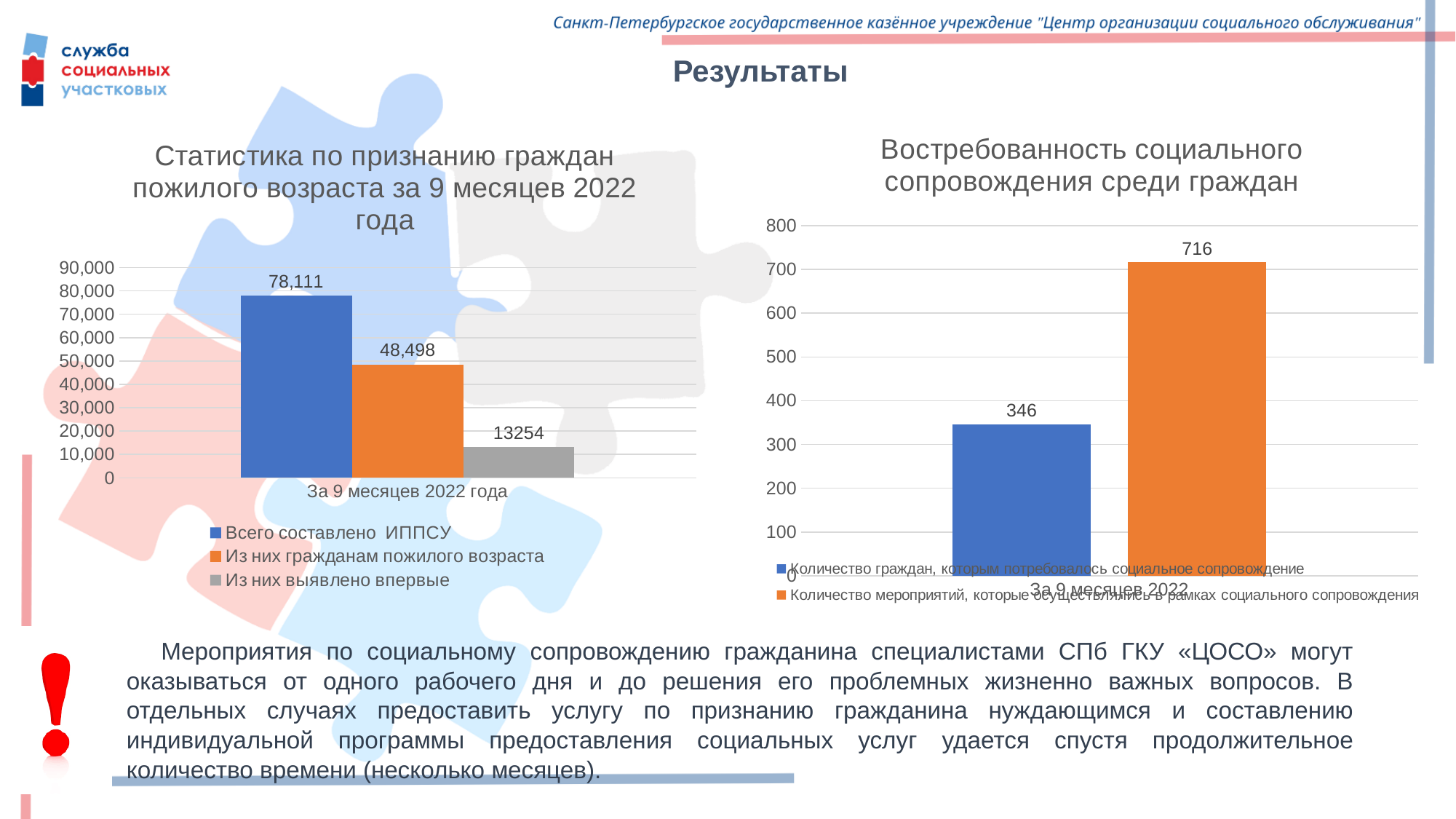
What kind of chart is the right chart? bar chart On the right chart, what colour is the bar for Количество мероприятий, которые осуществлялись в рамках социального сопровождения? orange On the left chart, what is the value for Из них выявлено впервые? 13254 On the left chart, which series has the lowest value? Из них выявлено впервые On the right chart, what is the difference between the number of мероприятий (716) and the number of граждан (346)? 370 On the left chart, what is the value for Из них гражданам пожилого возраста? 48,498 On the right chart (Востребованность социального сопровождения среди граждан), what is the value for Количество граждан, которым потребовалось социальное сопровождение? 346 On the left chart, how many series does the legend list? 3 On the right chart, what is the value for Количество мероприятий, которые осуществлялись в рамках социального сопровождения? 716 On the left chart, what is the difference between Всего составлено ИППСУ and Из них гражданам пожилого возраста? 29,613 On the left chart (Статистика по признанию граждан пожилого возраста за 9 месяцев 2022 года), what is the value for Всего составлено ИППСУ? 78,111 On the right chart, which series has the highest value? Количество мероприятий, которые осуществлялись в рамках социального сопровождения